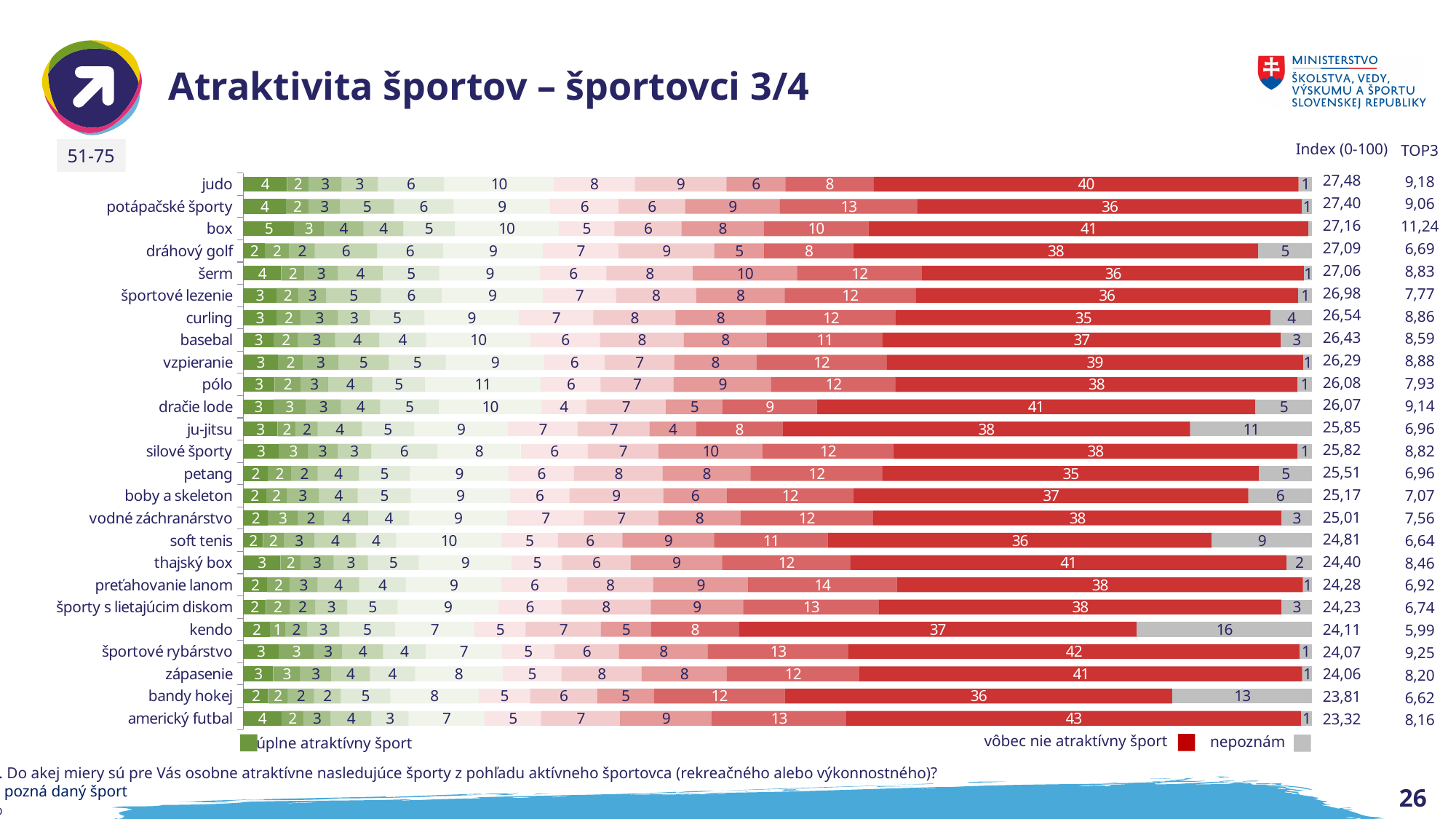
What is the TOP3 value shown for box? 11,24 What is the title of the slide's chart? Atraktivita športov – športovci 3/4 What is the Index (0-100) value shown for judo? 27,48 What is the value of the grey 'nepoznám' segment for kendo? 16 Which sport has the largest dark red 'vôbec nie atraktívny šport' segment? americký futbal How many sports (categories) are listed in the chart? 25 What is the difference between the 'nepoznám' values for kendo and bandy hokej? 3 Which sport has the lowest Index (0-100) value? americký futbal What is the value of the dark red 'vôbec nie atraktívny šport' segment for judo? 40 Which has a larger 'nepoznám' value, ju-jitsu or soft tenis? ju-jitsu What kind of chart is shown on the slide? bar chart Which sport has the largest grey 'nepoznám' segment? kendo